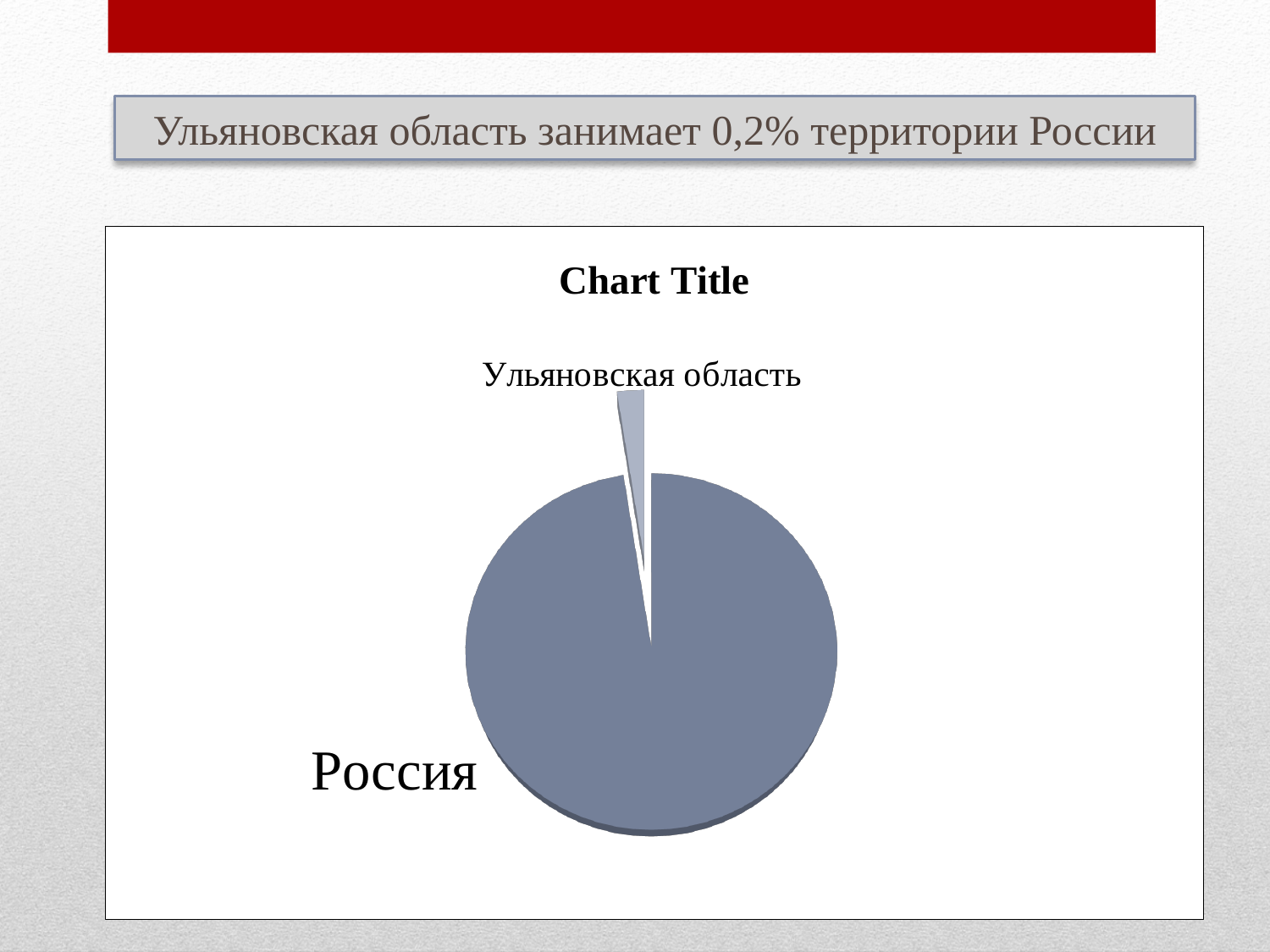
What kind of chart is shown on the slide? pie chart Which slice is larger, Россия or Ульяновская область? Россия Which slice of the pie chart is the largest? Россия What is the title printed above the pie chart? Chart Title Which slice is pulled out (separated) from the rest of the pie? Ульяновская область Which slice of the pie chart is the smallest? Ульяновская область How many slices does the pie chart have? 2 Does the Ульяновская область slice take up more or less than half of the pie? less Does the Россия slice take up more or less than half of the pie? more